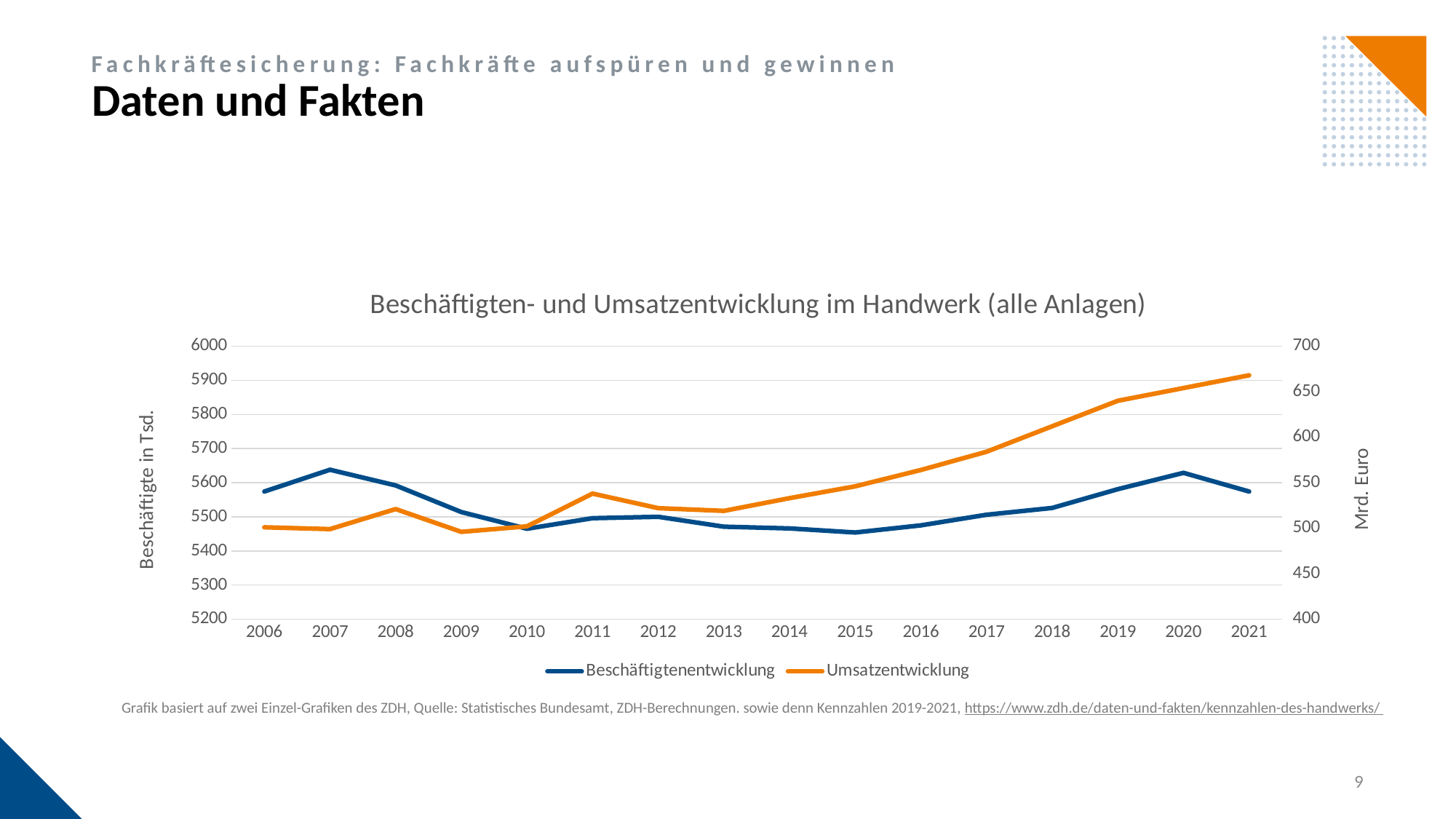
What kind of chart is shown on the slide? line chart Is the Beschäftigtenentwicklung value for 2015 greater or less than 5500? less Which year has the larger Beschäftigtenentwicklung value, 2015 or 2020? 2020 Is the Umsatzentwicklung value for 2021 greater or less than 650? greater Is the Beschäftigtenentwicklung value for 2007 greater or less than 5600? greater Does the Umsatzentwicklung line rise or fall between 2013 and 2021? rise How many series does the legend list? 2 How many years are plotted along the x axis? 16 What is the title of the chart? Beschäftigten- und Umsatzentwicklung im Handwerk (alle Anlagen) What is the label of the right-hand vertical axis? Mrd. Euro In which year is the Umsatzentwicklung line at its highest? 2021